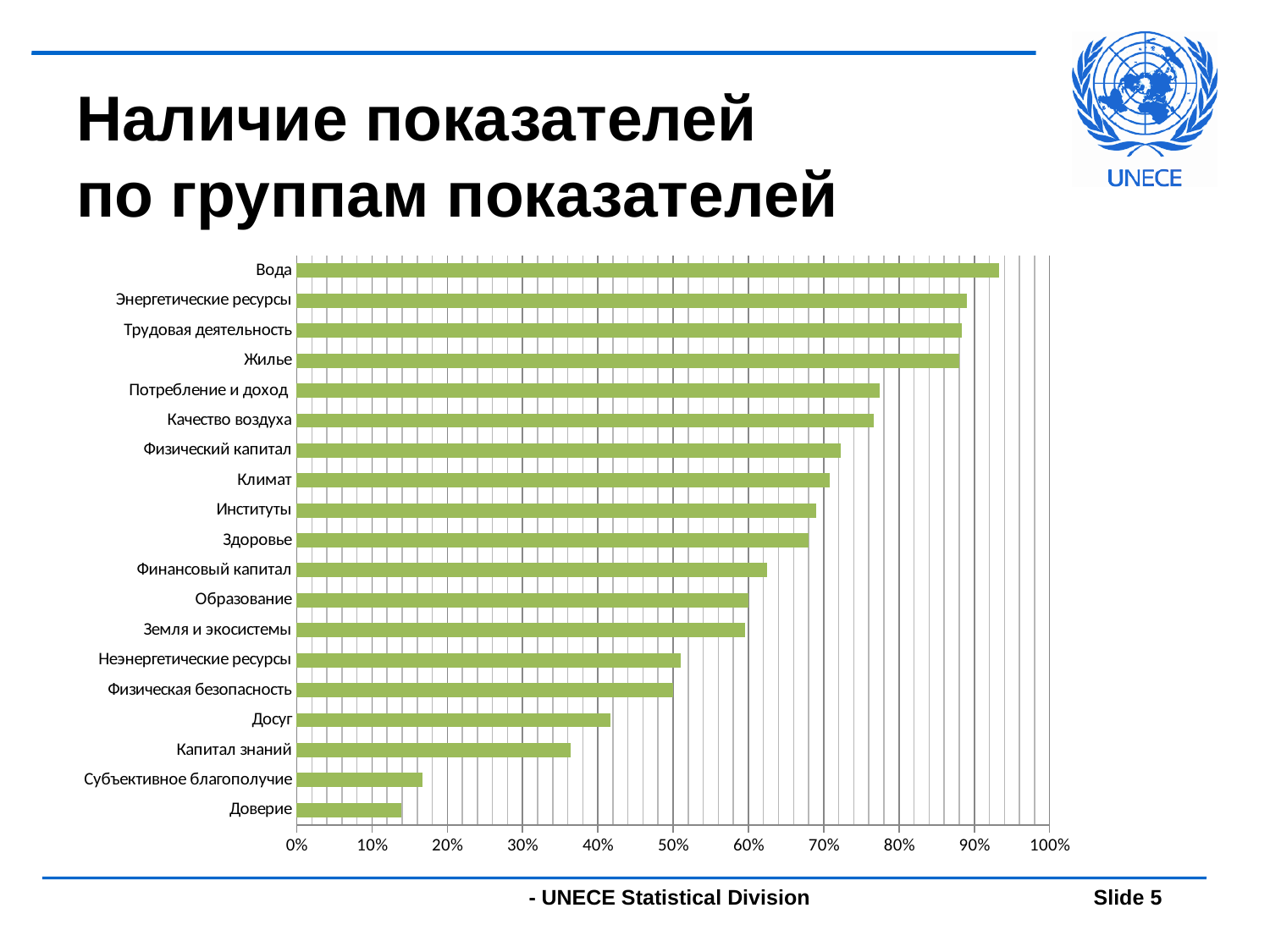
Is the value for Доверие greater or less than 20%? less How many categories are plotted in the chart? 19 Which is larger, the value for Досуг or the value for Капитал знаний? Досуг Which is larger, the value for Здоровье or the value for Физическая безопасность? Здоровье What kind of chart is shown on the slide? bar chart What is the title of the slide containing the chart? Наличие показателей по группам показателей Is the value for Субъективное благополучие greater or less than 30%? less Which category has the highest value? Вода Is the value for Вода greater or less than 90%? greater Which category has the lowest value? Доверие